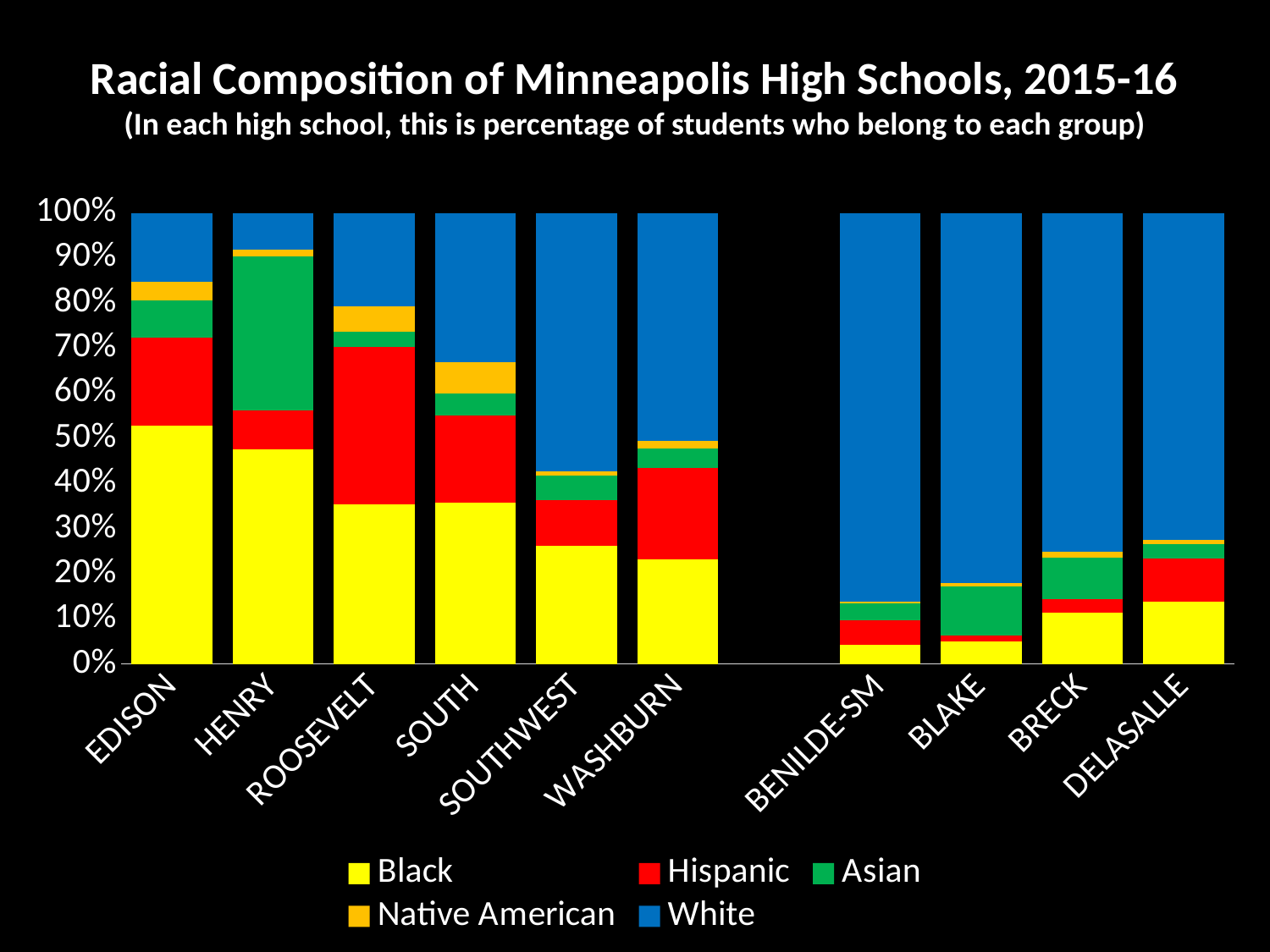
Which has the larger White share of students, EDISON or HENRY? EDISON Which has the larger Hispanic share of students, ROOSEVELT or EDISON? ROOSEVELT What is the title of the chart? Racial Composition of Minneapolis High Schools, 2015-16 Is the Black share of students at BENILDE-SM greater or less than 10%? less How many series does the legend list? 5 How many high schools are shown on the x axis? 10 Which high school has the largest Black share of students? EDISON Is the Black share of students at EDISON greater or less than 40%? greater Which high school has the largest Asian share of students? HENRY Is the Black share of students at WASHBURN greater or less than 30%? less What kind of chart is shown on the slide? stacked bar chart Which colour represents the Asian series in the legend? green